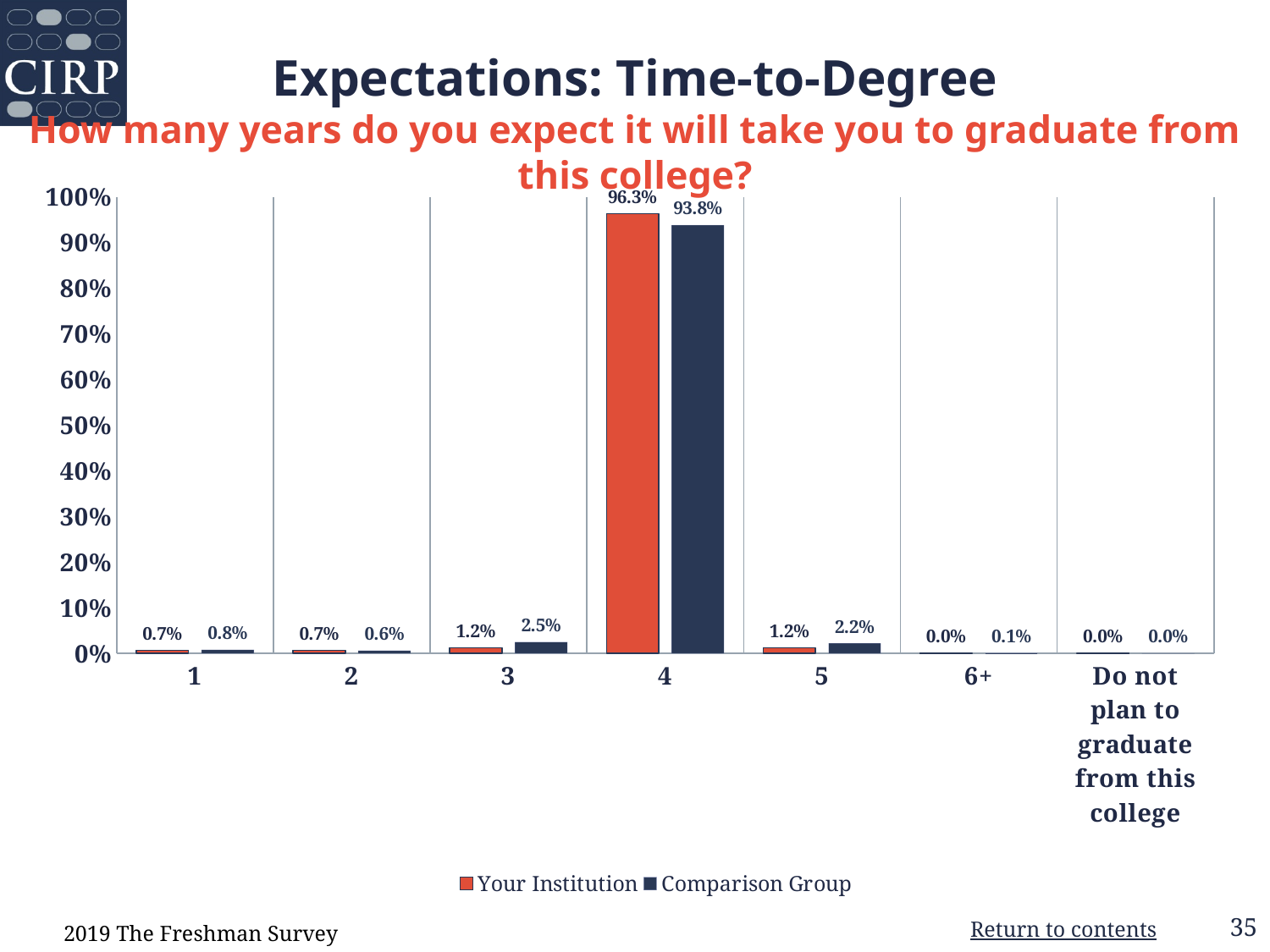
What is the value for Your Institution for the category 5? 1.2% What is the value for Comparison Group for the category 3? 2.5% Is the value for Your Institution for the category 4 greater or less than 90%? greater How many categories are shown on the x axis? 7 Which category has the highest value for Comparison Group? 4 What kind of chart is shown on the slide? bar chart What is the value for Your Institution for the category 4? 96.3% What is the value for Comparison Group for the category 6+? 0.1% What is the difference between Comparison Group and Your Institution for the category 5? 1.0% What is the difference between Your Institution and Comparison Group for the category 4? 2.5% How many series does the legend list? 2 For the category 3, which is larger: Your Institution or Comparison Group? Comparison Group